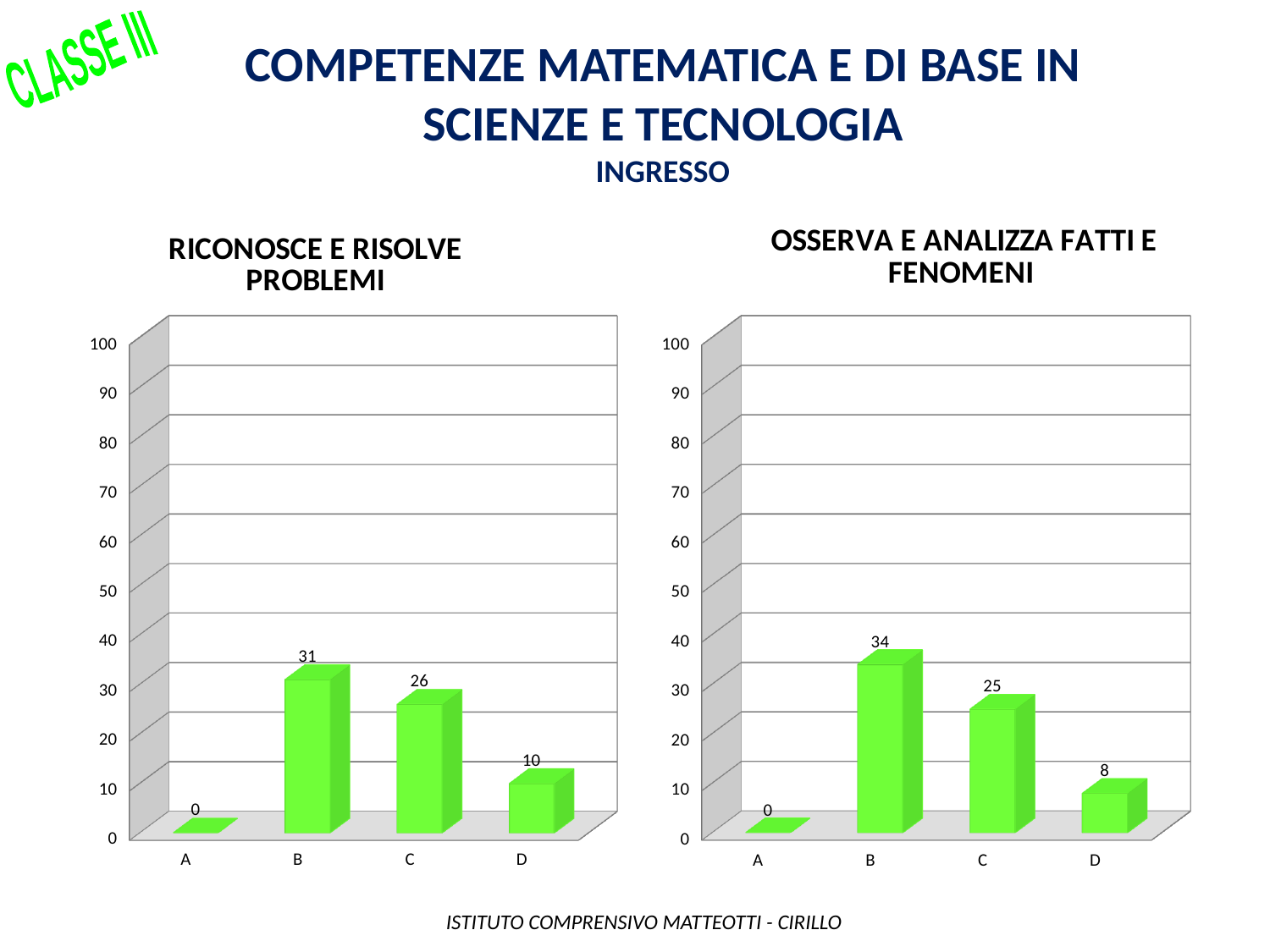
What kind of chart is the 'OSSERVA E ANALIZZA FATTI E FENOMENI' chart? Bar chart In the 'RICONOSCE E RISOLVE PROBLEMI' chart, what is the value for category B? 31 In the 'OSSERVA E ANALIZZA FATTI E FENOMENI' chart, what is the difference between the values for B and D? 26 In the 'RICONOSCE E RISOLVE PROBLEMI' chart, which category has the highest value? B In the 'RICONOSCE E RISOLVE PROBLEMI' chart, what is the difference between the values for B and C? 5 In the 'OSSERVA E ANALIZZA FATTI E FENOMENI' chart, which category has the lowest value? A Which is larger: the value for C in the 'RICONOSCE E RISOLVE PROBLEMI' chart or the value for C in the 'OSSERVA E ANALIZZA FATTI E FENOMENI' chart? RICONOSCE E RISOLVE PROBLEMI (26) In the 'OSSERVA E ANALIZZA FATTI E FENOMENI' chart, what is the value for category D? 8 What is the maximum value shown on the vertical axis of the 'RICONOSCE E RISOLVE PROBLEMI' chart? 100 How many categories are shown in the 'RICONOSCE E RISOLVE PROBLEMI' chart? 4 In the 'OSSERVA E ANALIZZA FATTI E FENOMENI' chart, is the value for B greater or less than 30? greater In the 'RICONOSCE E RISOLVE PROBLEMI' chart, what is the value for category A? 0